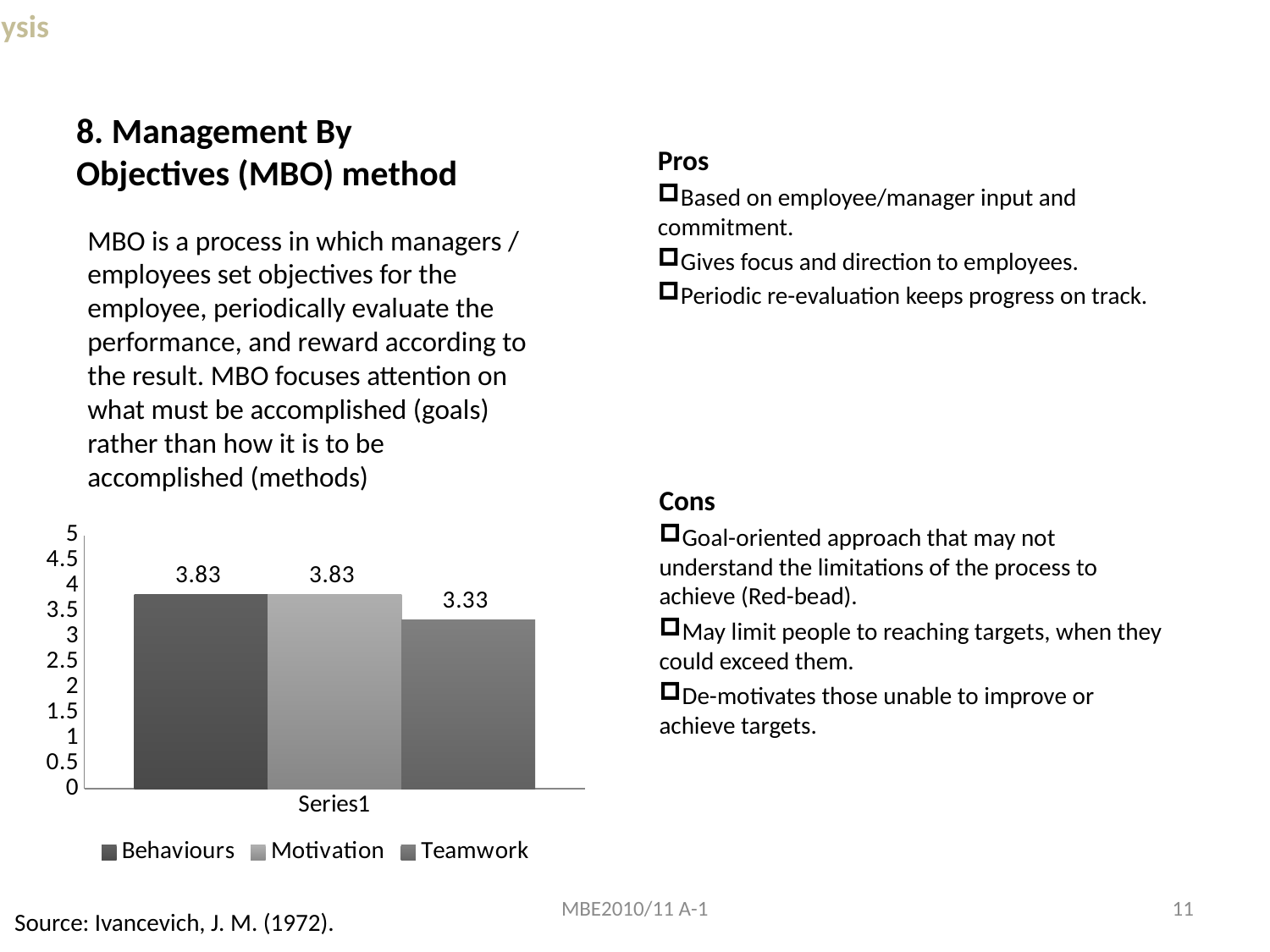
What is the value for Teamwork in the bar chart? 3.33 How many series does the legend of the chart list? 3 What is the difference between the values for Behaviours and Teamwork? 0.5 How many bars are plotted in the chart? 3 Which series has the lowest value in the bar chart? Teamwork What is the value for Behaviours in the bar chart? 3.83 Is the value for Behaviours greater or less than 3.5? greater What is the category label shown on the x axis of the chart? Series1 What kind of chart is shown on the slide? bar chart Which is larger, the value for Motivation or the value for Teamwork? Motivation What is the value for Motivation in the bar chart? 3.83 Is the value for Teamwork greater or less than 3.5? less